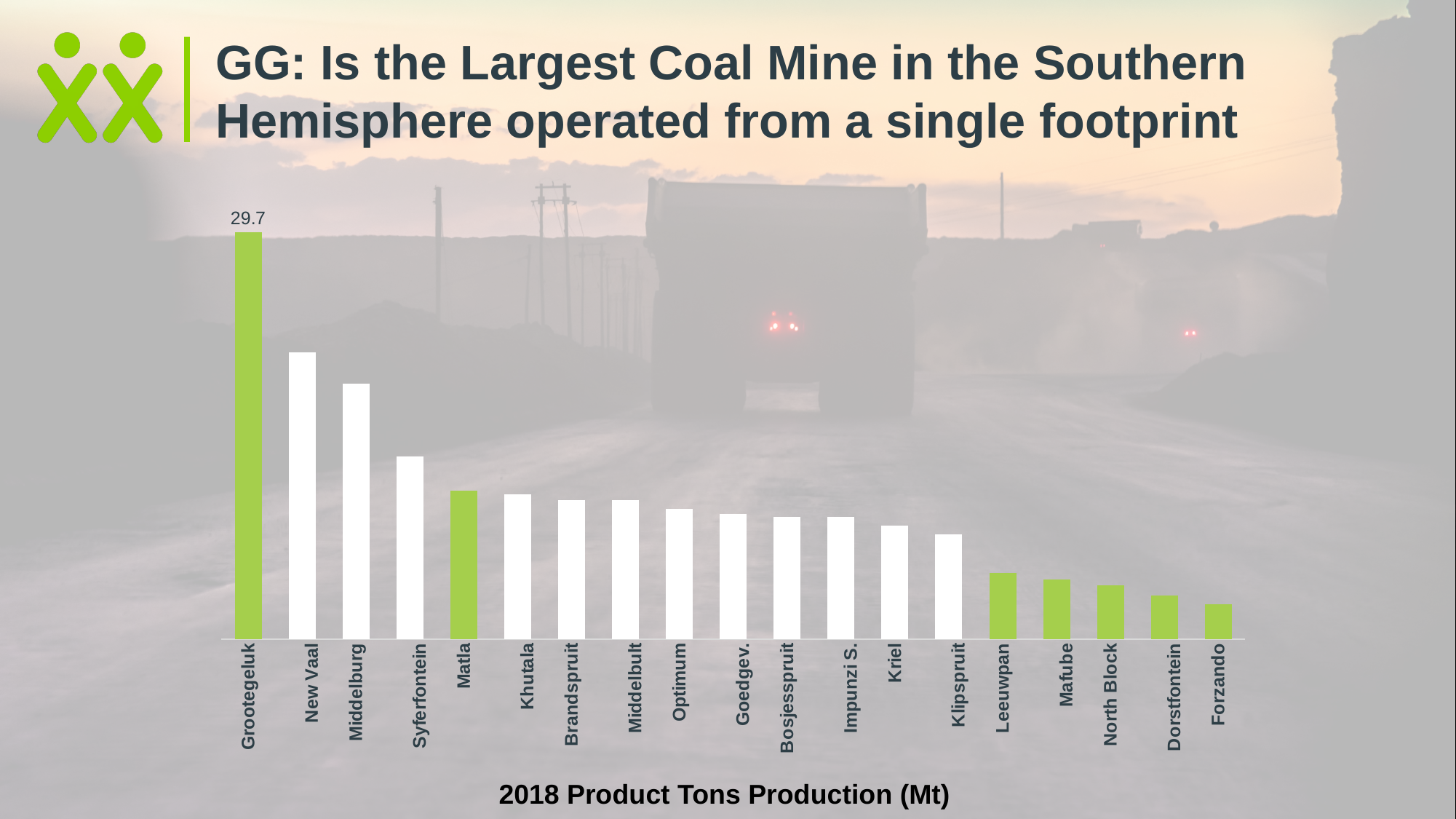
Which mine has the highest 2018 production in the chart? Grootegeluk Which has the larger value, Klipspruit or Leeuwpan? Klipspruit What kind of chart is shown on the slide? Bar chart How many bars in the chart are coloured green? 7 Do the values rise or fall moving from left to right along the x axis? Fall How many mines are shown on the x axis of the chart? 19 What is the value shown for Grootegeluk? 29.7 Which mine is the second highest in the chart? New Vaal What is the axis title shown below the chart? 2018 Product Tons Production (Mt) Which has the larger value, Syferfontein or Matla? Syferfontein Which mine has the lowest 2018 production in the chart? Forzando Which has the larger value, New Vaal or Middelburg? New Vaal